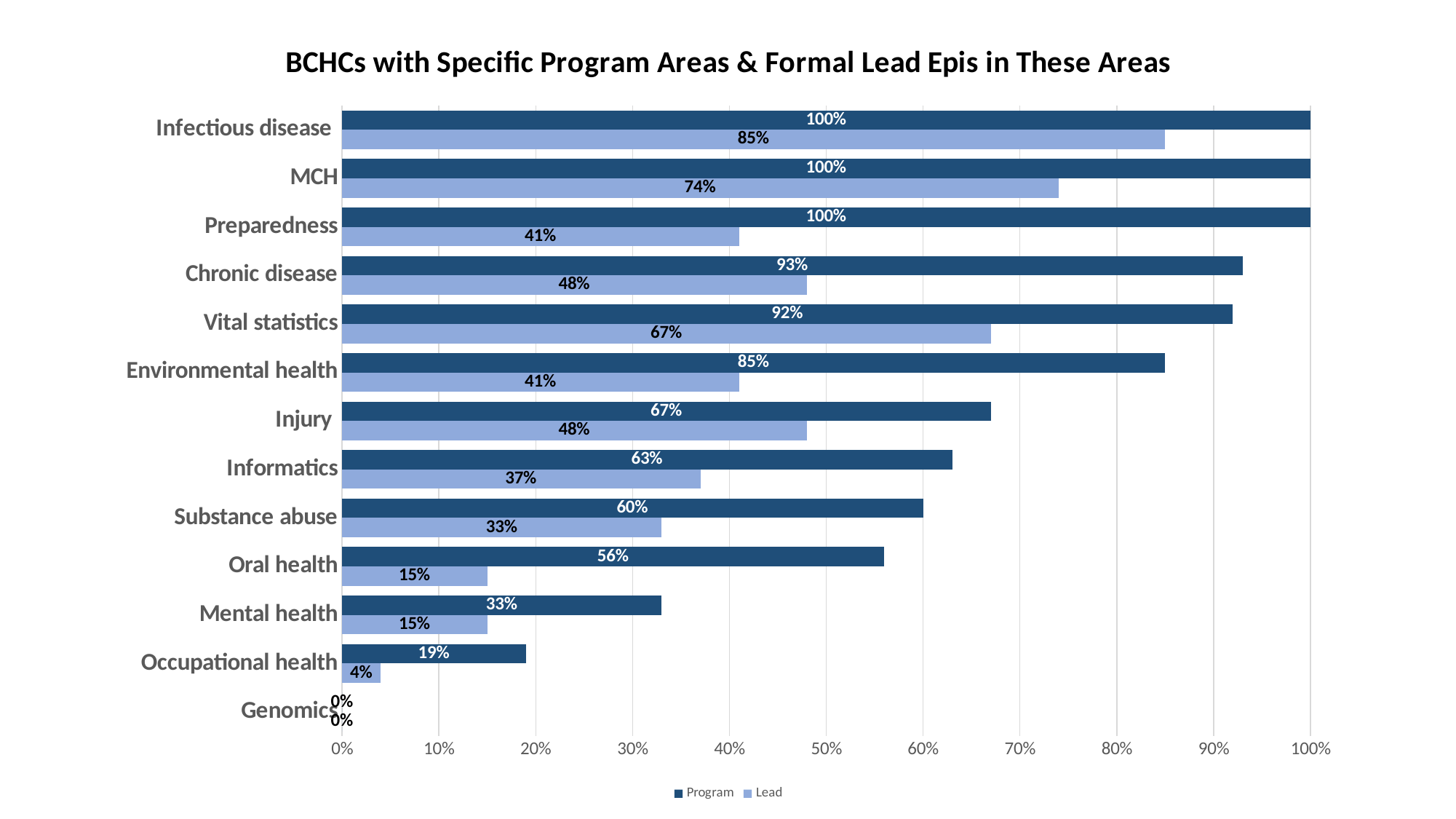
What is the Lead value for Vital statistics? 67% Which is larger: the Lead value for MCH or the Lead value for Vital statistics? MCH What is the title of the chart? BCHCs with Specific Program Areas & Formal Lead Epis in These Areas Which category has the lowest Lead value? Genomics How many series does the legend list? 2 How many program area categories are shown on the chart? 13 What is the difference between the Program and Lead values for Preparedness? 59% What kind of chart is shown on the slide? Bar chart What are the two series named in the legend? Program and Lead What is the Program value for Chronic disease? 93% What is the Lead value for Occupational health? 4% Which category has the highest Lead value? Infectious disease